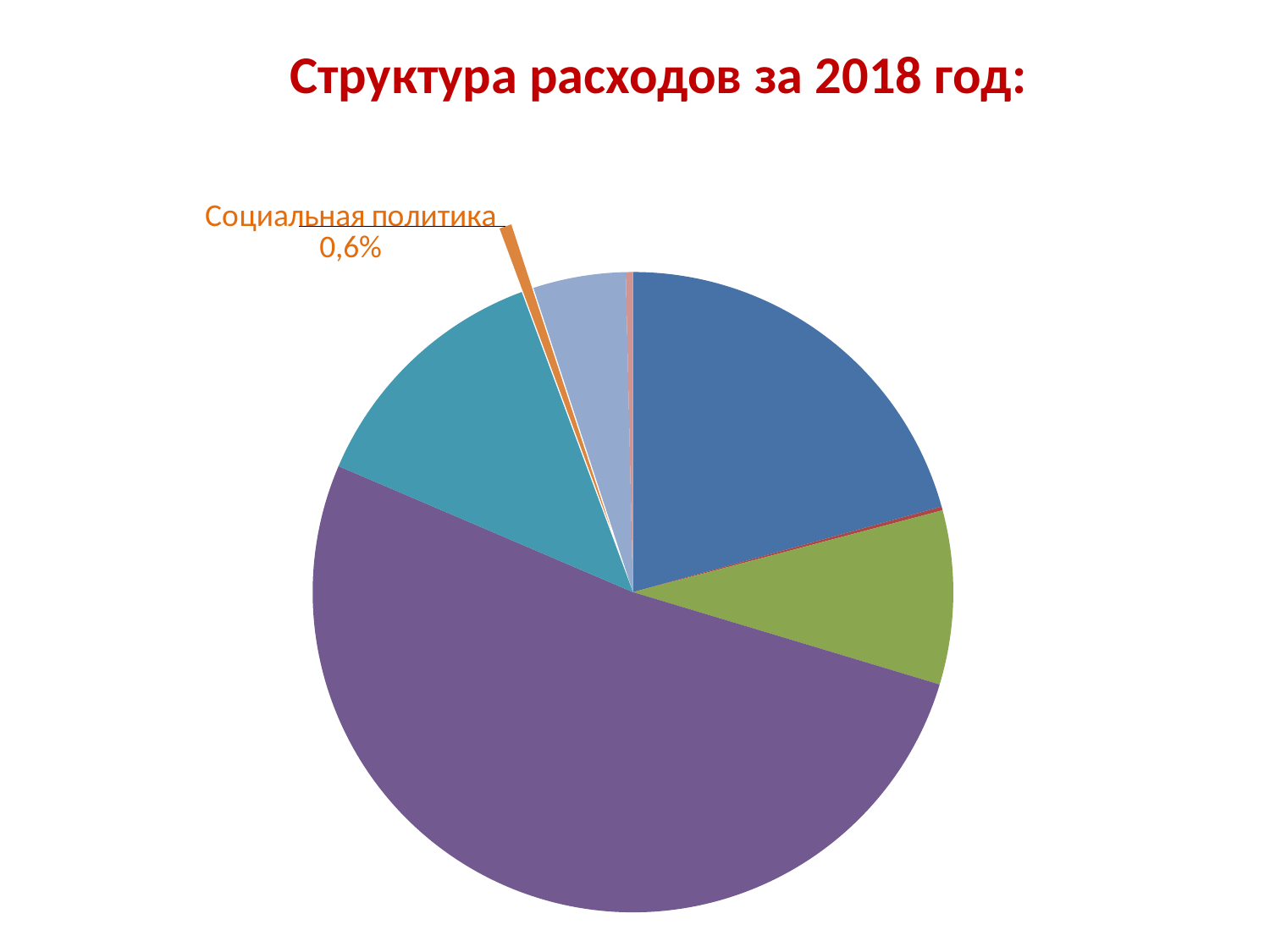
What is the title of the chart? Структура расходов за 2018 год: What share of the pie does Социальная политика account for? 0,6% Is the Социальная политика slice one of the smallest or one of the largest slices in the pie? one of the smallest What is the value shown for the Социальная политика slice? 0,6% What kind of chart is shown on the slide? pie chart What colour is the largest slice of the pie? purple